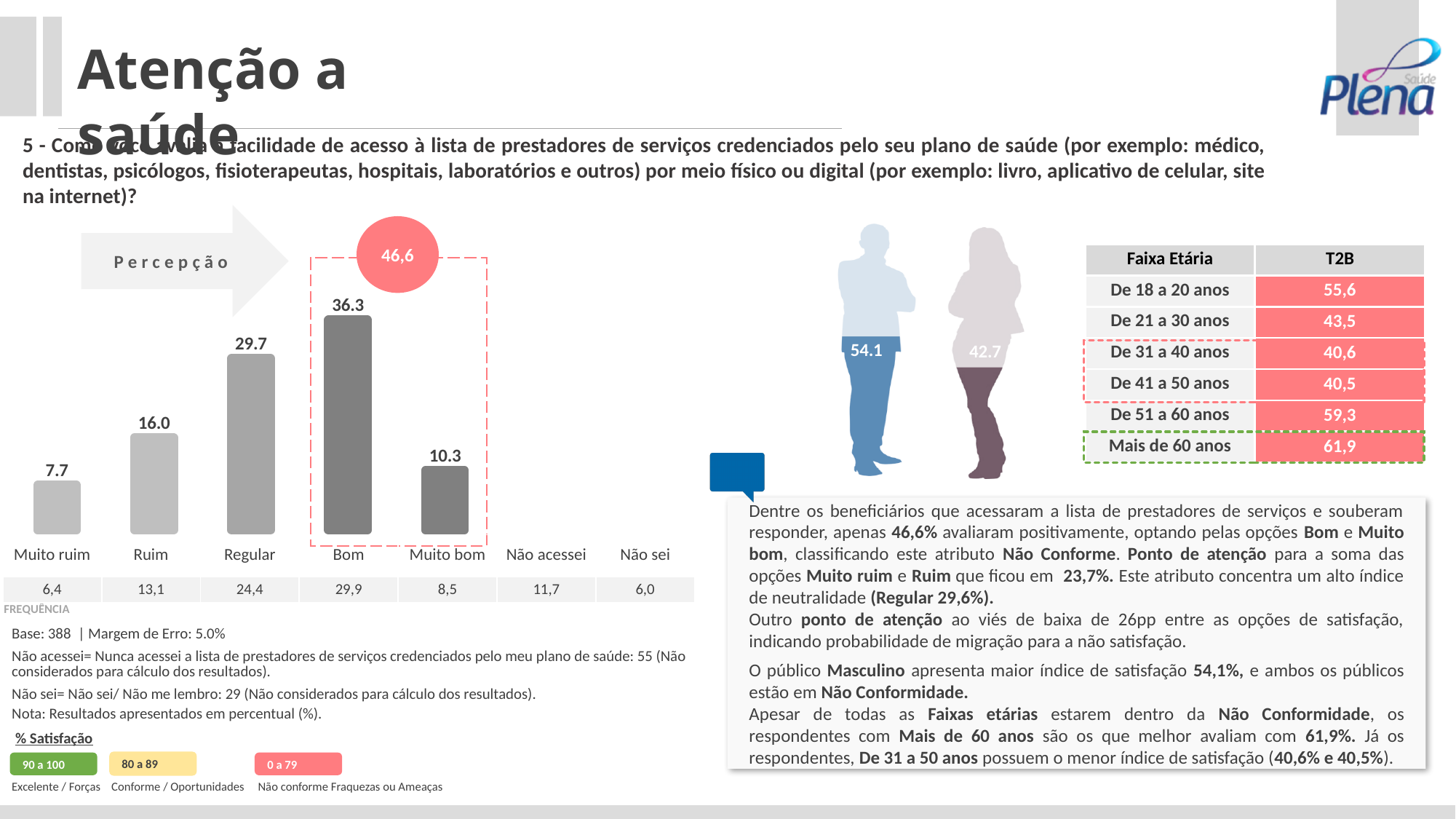
What value is shown in the pink circle above the Bom and Muito bom bars? 46,6 In the bar chart, what is the value for Regular? 29.7 What is the difference between the values for Bom and Muito bom in the bar chart? 26.0 Which category has the lowest bar in the chart? Muito ruim Which category has the highest bar in the chart? Bom What type of chart is shown on the left of the slide? bar chart In the bar chart, what is the value for Muito bom? 10.3 How many bars are plotted in the bar chart? 5 In the bar chart, what is the value for Muito ruim? 7.7 What is the difference between the values for Regular and Ruim in the bar chart? 13.7 Which is larger in the bar chart, Ruim or Muito bom? Ruim In the bar chart, what is the value for Bom? 36.3